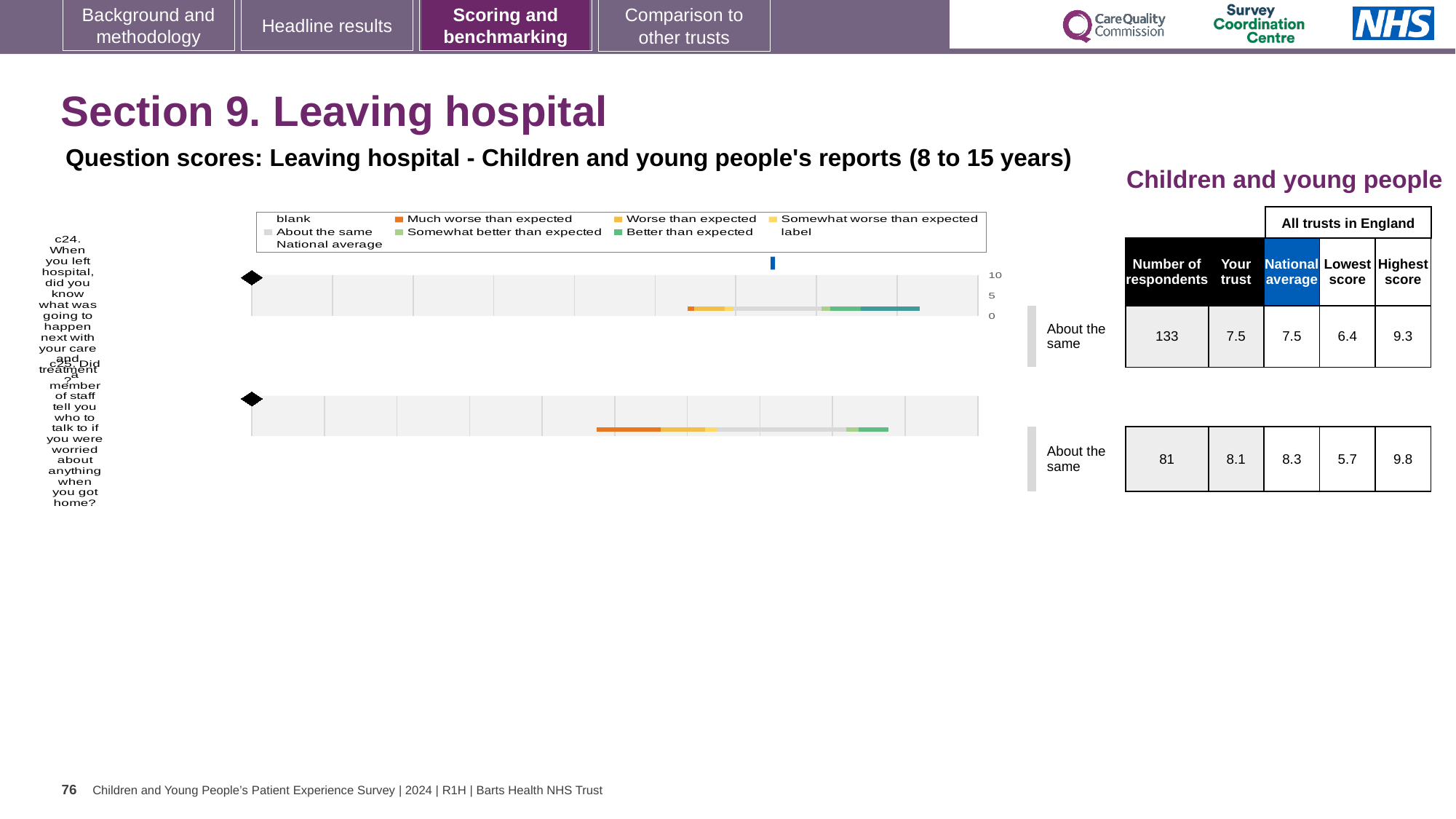
What is the 'Your trust' score for question c24 (When you left hospital, did you know what was going to happen next with your care and treatment?)? 7.5 What benchmark category is shown next to the chart for question c24? About the same Which question has the higher 'Your trust' score, c24 or c25? c25 What colour in the legend represents 'Much worse than expected'? Orange What is the lowest score among all trusts in England for question c25 (Did a member of staff tell you who to talk to if you were worried about anything when you got home?)? 5.7 What is the difference between the highest score and the lowest score for question c24? 2.9 What is the highest score among all trusts in England for question c25? 9.8 How many respondents answered question c24? 133 How many survey questions are plotted in the chart? 2 What kind of chart is used to show the benchmarking bands for each question? bar chart What is the national average score for question c24? 7.5 For question c25, which is larger: the 'Your trust' score or the national average? National average